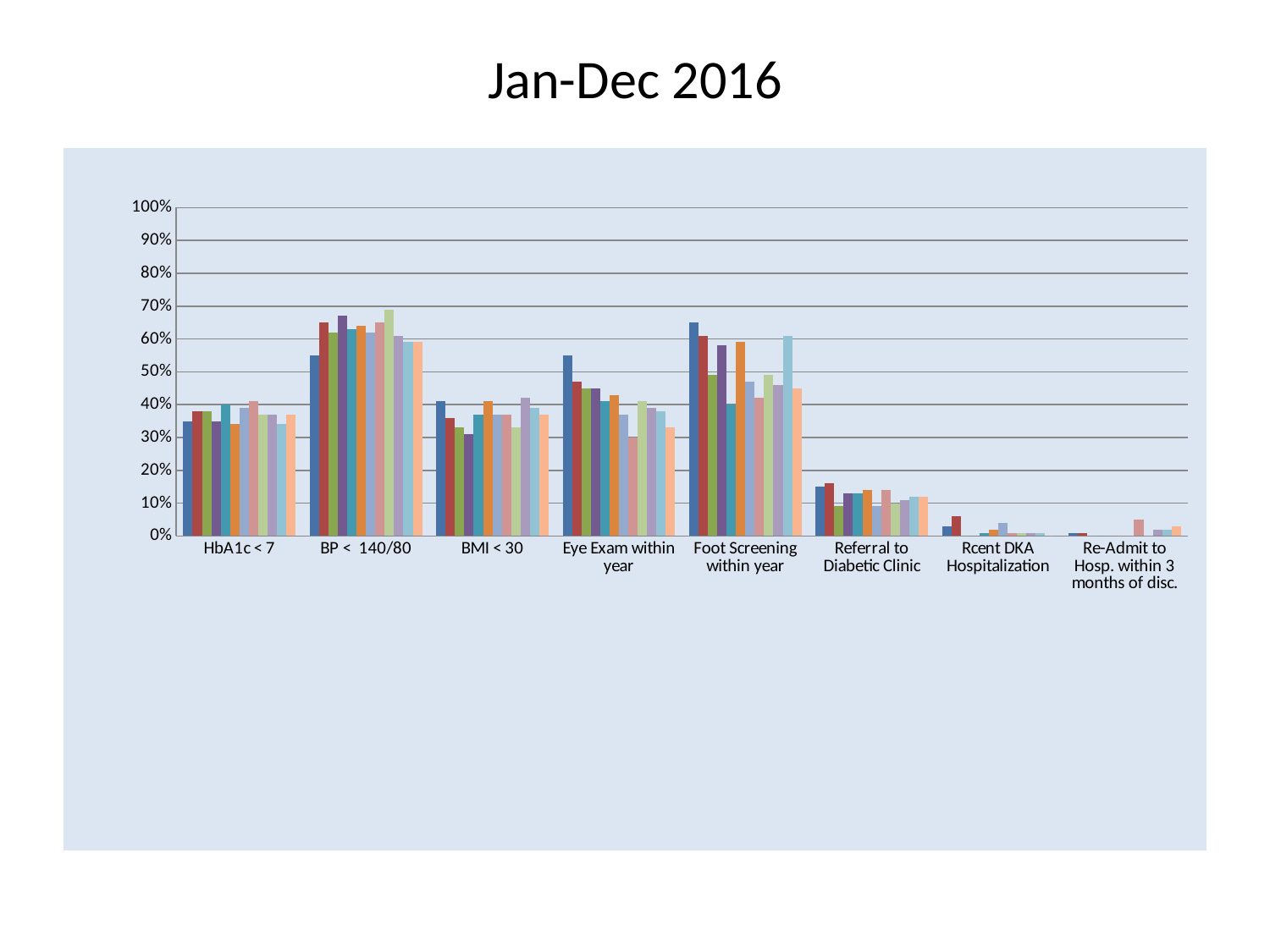
What is the title of the slide? Jan-Dec 2016 Which category has higher values overall, BP < 140/80 or HbA1c < 7? BP < 140/80 What is the maximum value shown on the y axis of the chart? 100% What kind of chart is shown on the slide? bar chart How many categories are shown along the x axis of the chart? 8 Are the bars for HbA1c < 7 greater or less than 50%? less Which category has higher values overall, Foot Screening within year or Referral to Diabetic Clinic? Foot Screening within year Are the bars for BP < 140/80 greater or less than 50%? greater Are the bars for Referral to Diabetic Clinic greater or less than 20%? less Which category has the lowest bars overall in the chart? Re-Admit to Hosp. within 3 months of disc. Which category contains the tallest bar in the chart? BP < 140/80